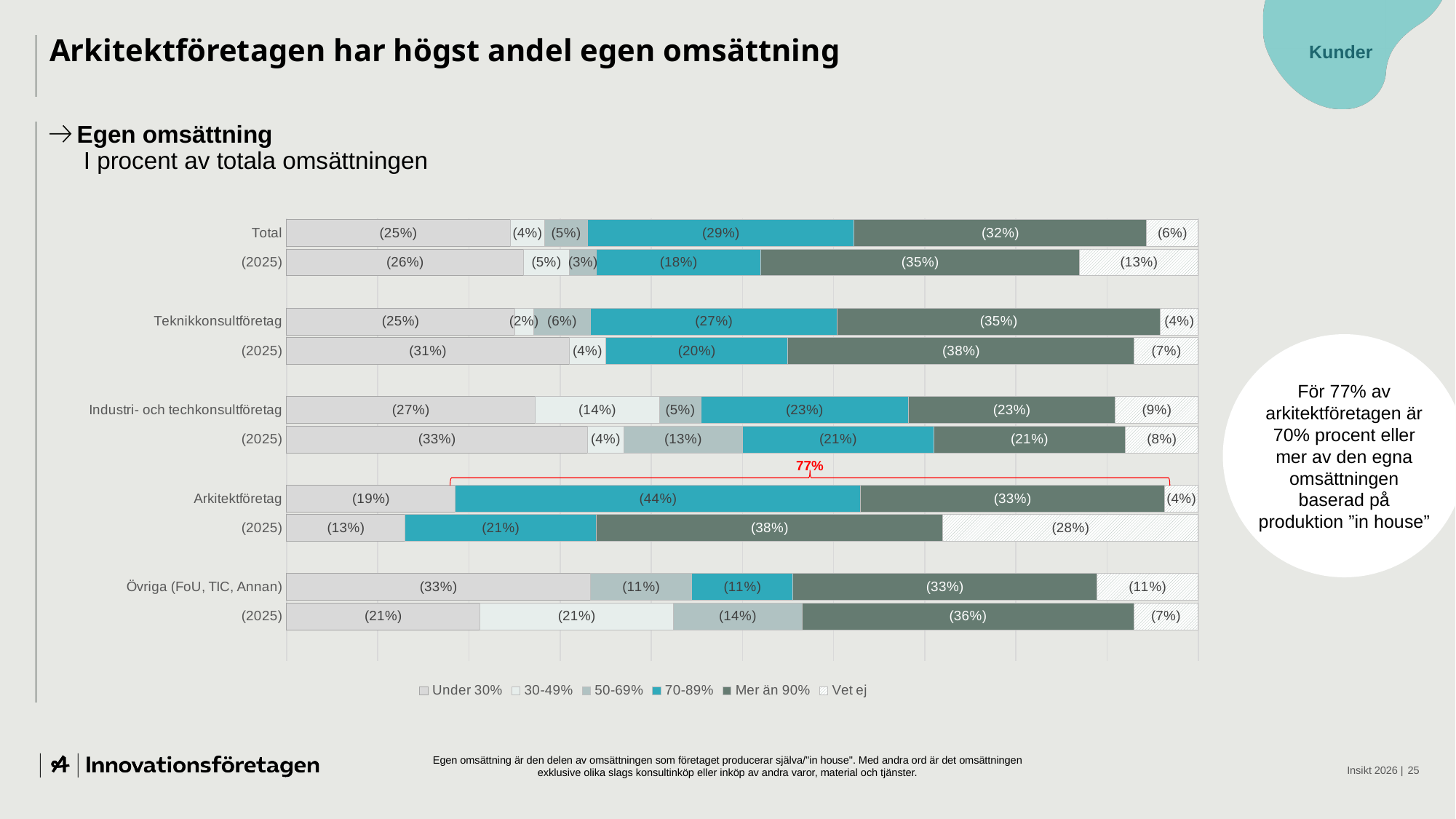
What share of Arkitektföretag fall in the 70-89% category? 44% What share of Arkitektföretag (2025) answered 'Vet ej'? 28% What is the combined share of Arkitektföretag in the 70-89% and 'Mer än 90%' categories, as annotated on the chart? 77% How many series does the legend list? 6 Which is larger: the 'Under 30%' share for Industri- och techkonsultföretag (2025) or for Arkitektföretag (2025)? Industri- och techkonsultföretag (2025) What is the difference between the 'Mer än 90%' share for Teknikkonsultföretag (2025) and Teknikkonsultföretag? 3% What share of Total fall in the 'Mer än 90%' category? 32% What is the subtitle of the chart? I procent av totala omsättningen What share of Industri- och techkonsultföretag answered 'Vet ej'? 9% Which category has the largest share in the 70-89% segment? Arkitektföretag What kind of chart is shown on the slide? Stacked bar chart What share of Övriga (FoU, TIC, Annan) fall in the 'Under 30%' category? 33%